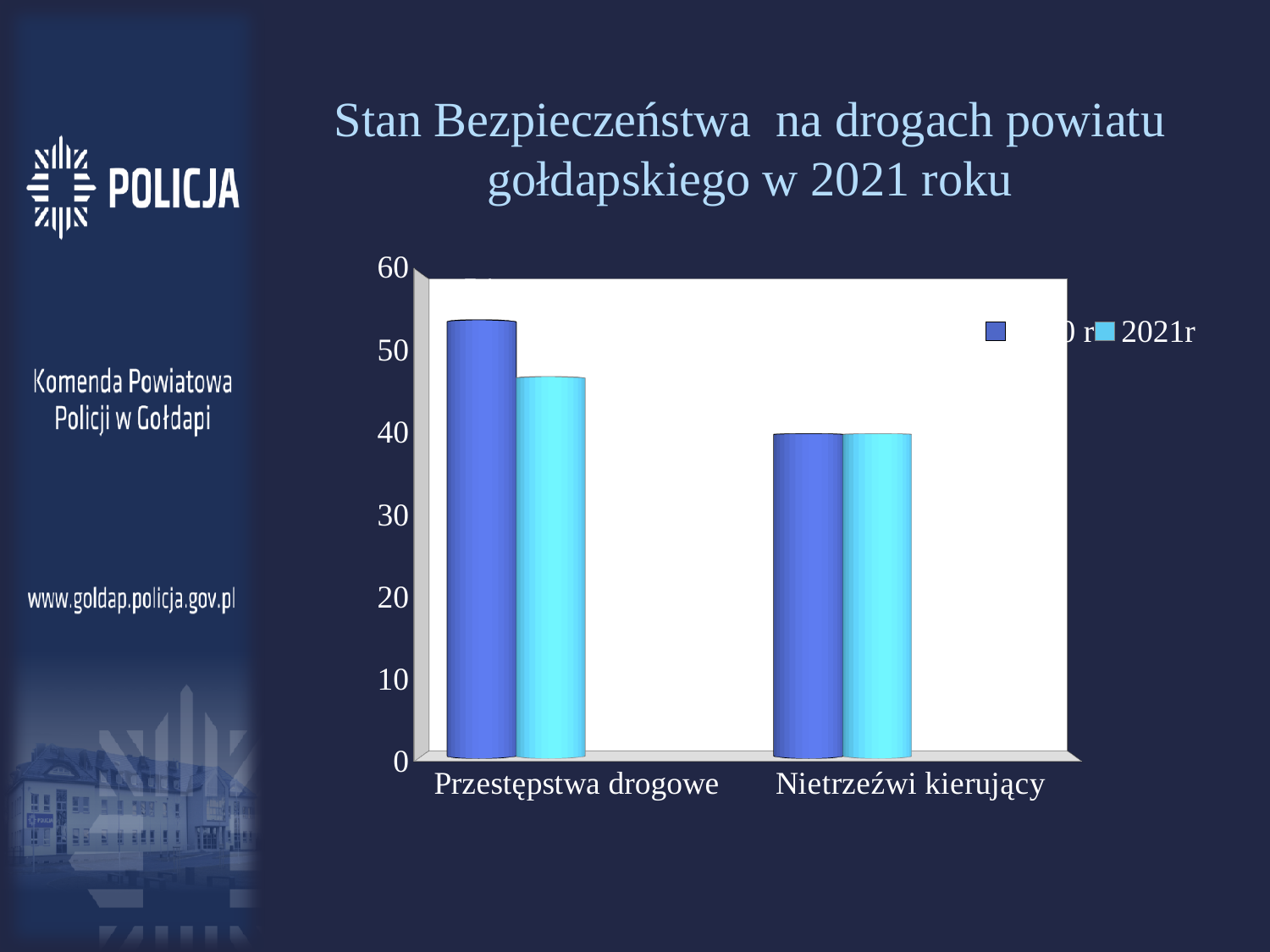
What kind of chart is shown on the slide? bar chart Is the value of the 2021r bar for Nietrzeźwi kierujący greater or less than 50? less For Przestępstwa drogowe, which bar is taller: the dark blue bar or the 2021r bar? the dark blue bar In the dark blue series, which category has the lowest value? Nietrzeźwi kierujący Is the value of the dark blue bar for Przestępstwa drogowe greater or less than 50? greater In the 2021r series, which category has the higher value? Przestępstwa drogowe Is the value of the 2021r bar for Przestępstwa drogowe greater or less than 50? less What colour are the bars for the 2021r series? light blue How many categories are shown on the x axis of the chart? 2 How many series does the chart's legend list? 2